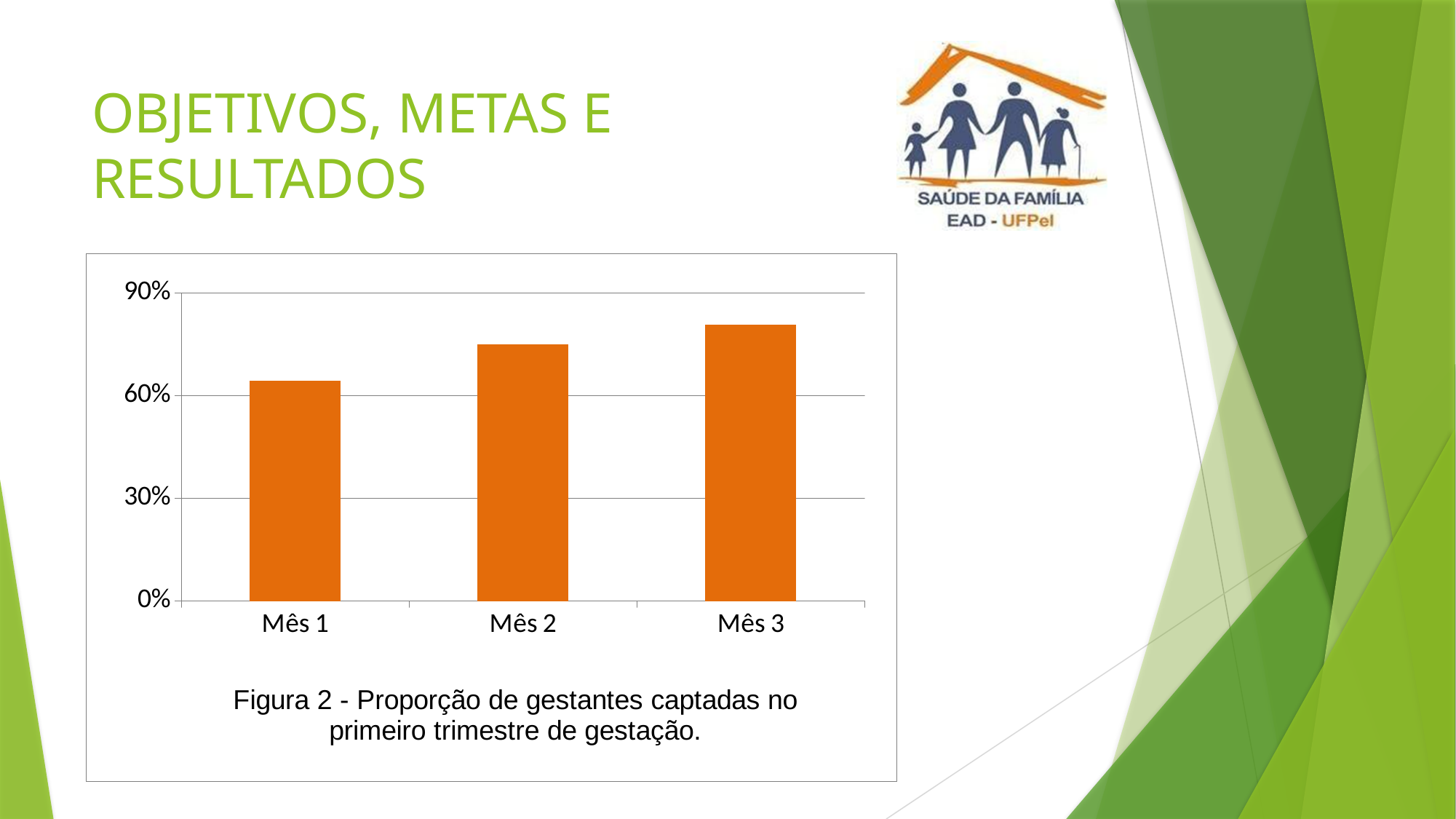
Is the value for Mês 1 greater or less than 60%? greater Which month has the lowest value on the chart? Mês 1 What is the caption (figure title) shown below the chart? Figura 2 - Proporção de gestantes captadas no primeiro trimestre de gestação. What colour are the bars in the chart? Orange Is the value for Mês 2 greater or less than 60%? greater How many categories (months) are plotted on the chart? 3 Which is larger, the value for Mês 2 or the value for Mês 3? Mês 3 What kind of chart is shown on the slide? Bar chart Which month has the highest proportion of pregnant women captured in the first trimester? Mês 3 Do the values rise or fall from Mês 1 to Mês 3? Rise Is the value for Mês 3 greater or less than 90%? less Which is larger, the value for Mês 1 or the value for Mês 2? Mês 2